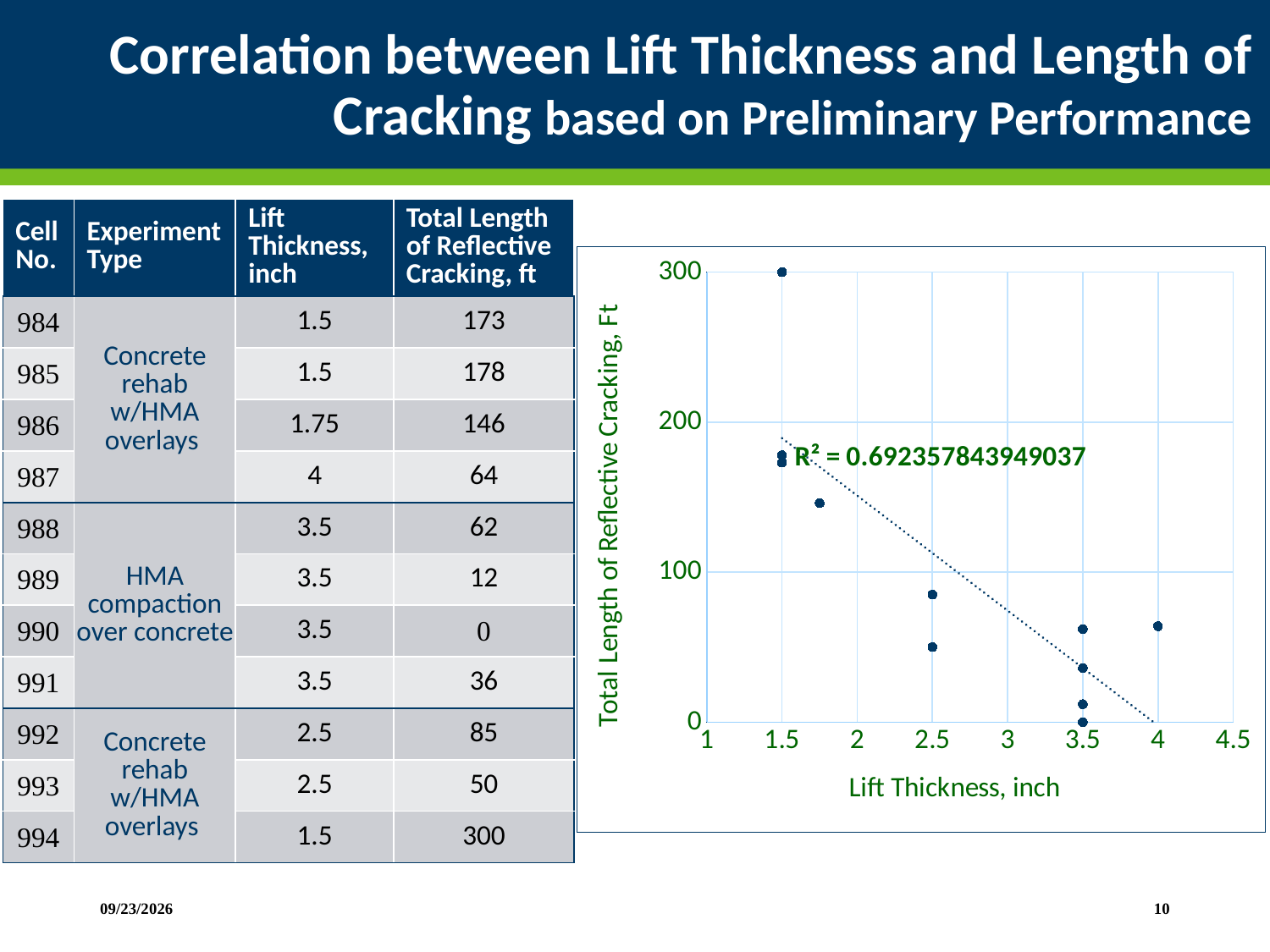
Is the value for the point at a lift thickness of 4 inch greater or less than 100? less What R² value is displayed on the chart? R² = 0.692357843949037 What is the value of the highest plotted point on the chart? 300 What kind of chart is shown on the slide? Scatter chart Which has the larger total length of reflective cracking: the point at 1.75 inch or the point at 4 inch? 1.75 inch Does the total length of reflective cracking generally rise or fall as lift thickness increases along the x axis? Fall At which lift thickness does the lowest plotted point (0 ft) occur? 3.5 What is the title of the y axis of the chart? Total Length of Reflective Cracking, Ft At which lift thickness does the highest plotted point occur? 1.5 What is the title of the x axis of the chart? Lift Thickness, inch Is the value for the point at a lift thickness of 1.75 inch greater or less than 100? greater What is the maximum value shown on the y axis of the chart? 300